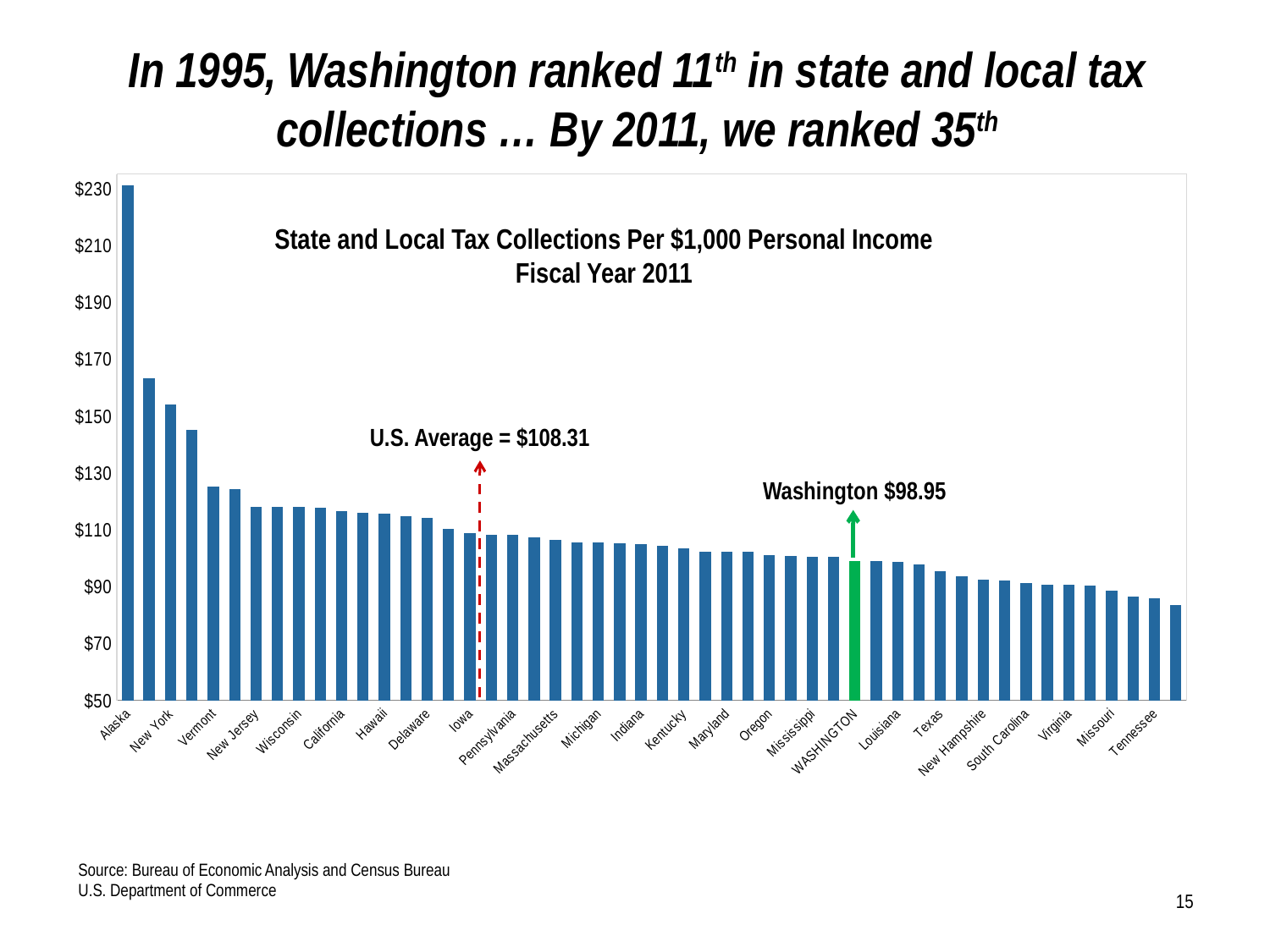
Which state has the highest tax collections per $1,000 personal income? Alaska What is the U.S. average shown on the chart? $108.31 Do the values rise or fall moving from left to right across the states? fall What type of chart is shown on the slide? bar chart Which has a higher value, Alaska or New York? Alaska What colour is the bar for Washington? green Which is larger, Washington's value or the U.S. average? U.S. average What is the title of the chart? State and Local Tax Collections Per $1,000 Personal Income Fiscal Year 2011 Is the value for Alaska greater or less than $210? greater What is the difference between the U.S. average and Washington's value? $9.36 What is the value of state and local tax collections per $1,000 personal income for Washington? $98.95 Is the value for Texas greater or less than $110? less